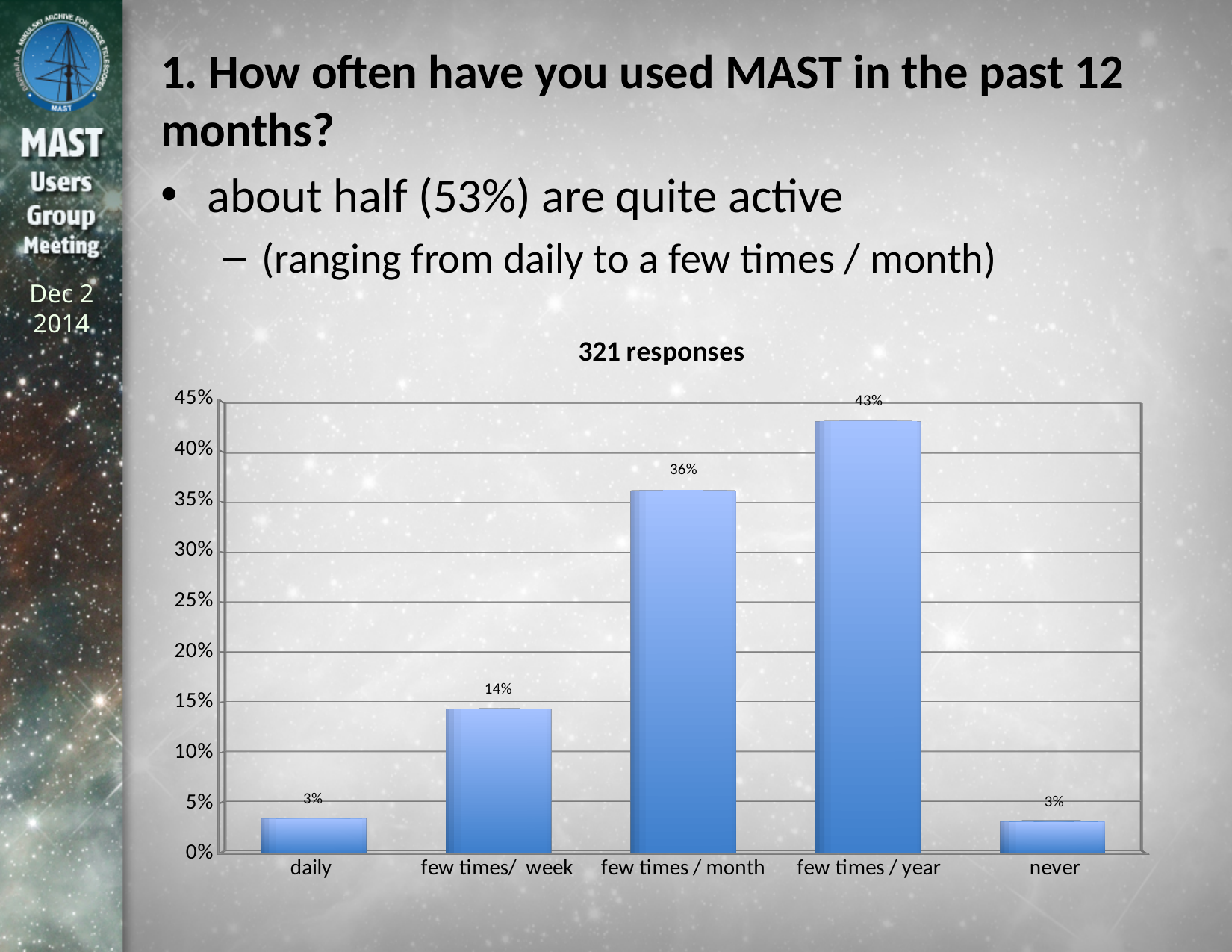
What is the difference between the 'few times / year' and 'few times / month' values? 7% Which category has the highest value? few times / year What kind of chart is shown on the slide? bar chart What is the title of the chart? 321 responses How many categories are shown on the x axis? 5 What is the combined value of the 'daily' and 'never' categories? 6% Is the value for 'few times / year' greater or less than 40%? greater What is the value shown for the 'daily' category? 3% Which is larger, the value for 'few times/ week' or the value for 'few times / month'? few times / month What is the maximum value shown on the y axis? 45% What percentage of respondents use MAST a few times per month? 36% What percentage of respondents use MAST a few times per week? 14%